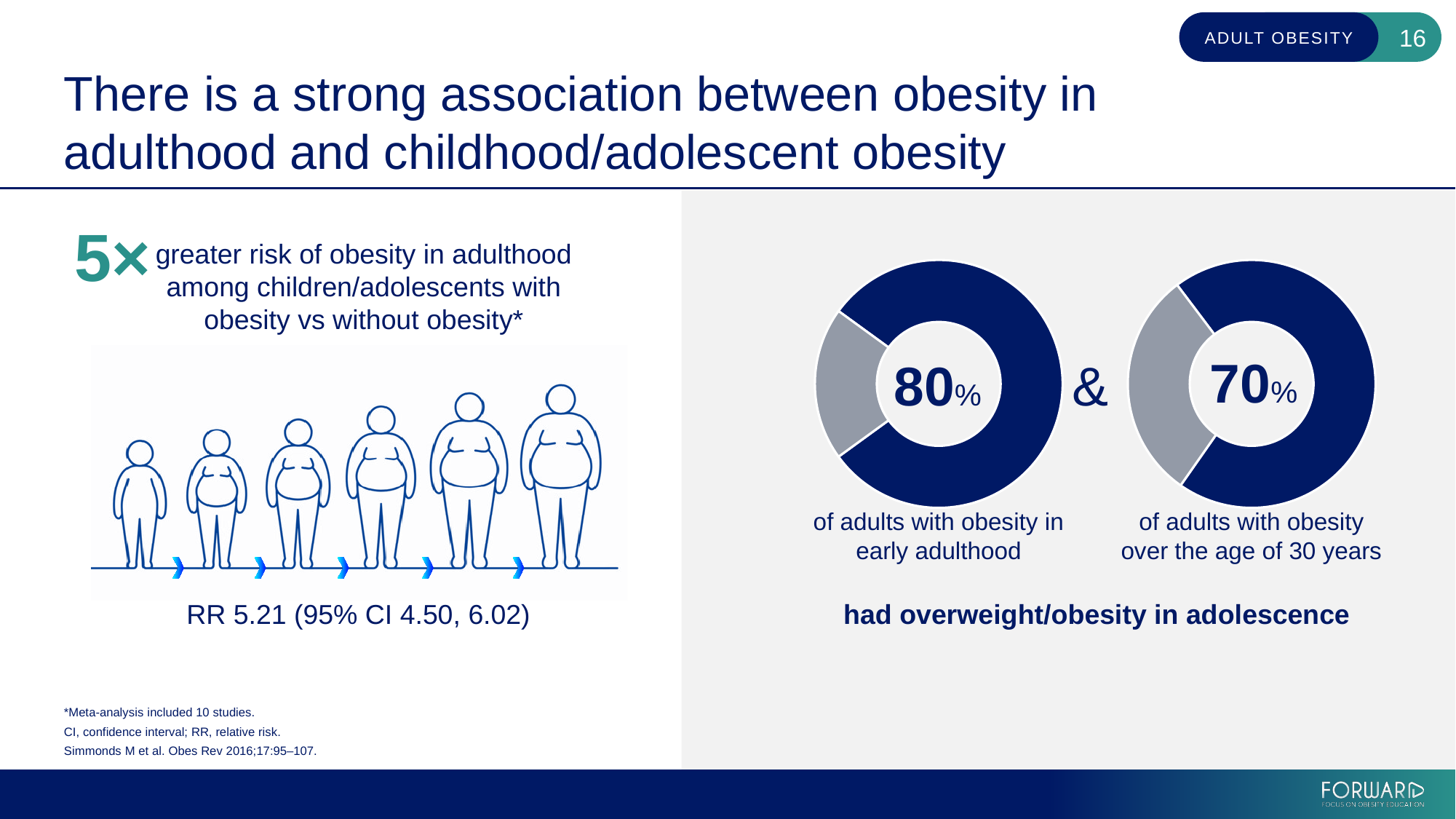
On the right donut chart, what percentage of adults with obesity over the age of 30 years had overweight/obesity in adolescence? 70% On the left donut chart, what percentage of adults with obesity in early adulthood had overweight/obesity in adolescence? 80% Which donut chart shows the larger percentage: adults with obesity in early adulthood or adults with obesity over the age of 30 years? Adults with obesity in early adulthood How many donut charts are shown on the slide? 2 Which of the two donut charts shows the lower percentage? The right chart (adults with obesity over the age of 30 years), 70% What colour is used for the highlighted (larger) segment in both donut charts? Dark blue On the left donut chart, what share of the circle is filled by the dark blue segment? 80% What does the text below the two donut charts say the percentages refer to? Had overweight/obesity in adolescence On the right donut chart, what share of the circle is filled by the grey segment? 30% What kind of charts are shown on the right side of the slide? Donut (pie) charts What is the difference in percentage points between the left donut chart (80%) and the right donut chart (70%)? 10 percentage points